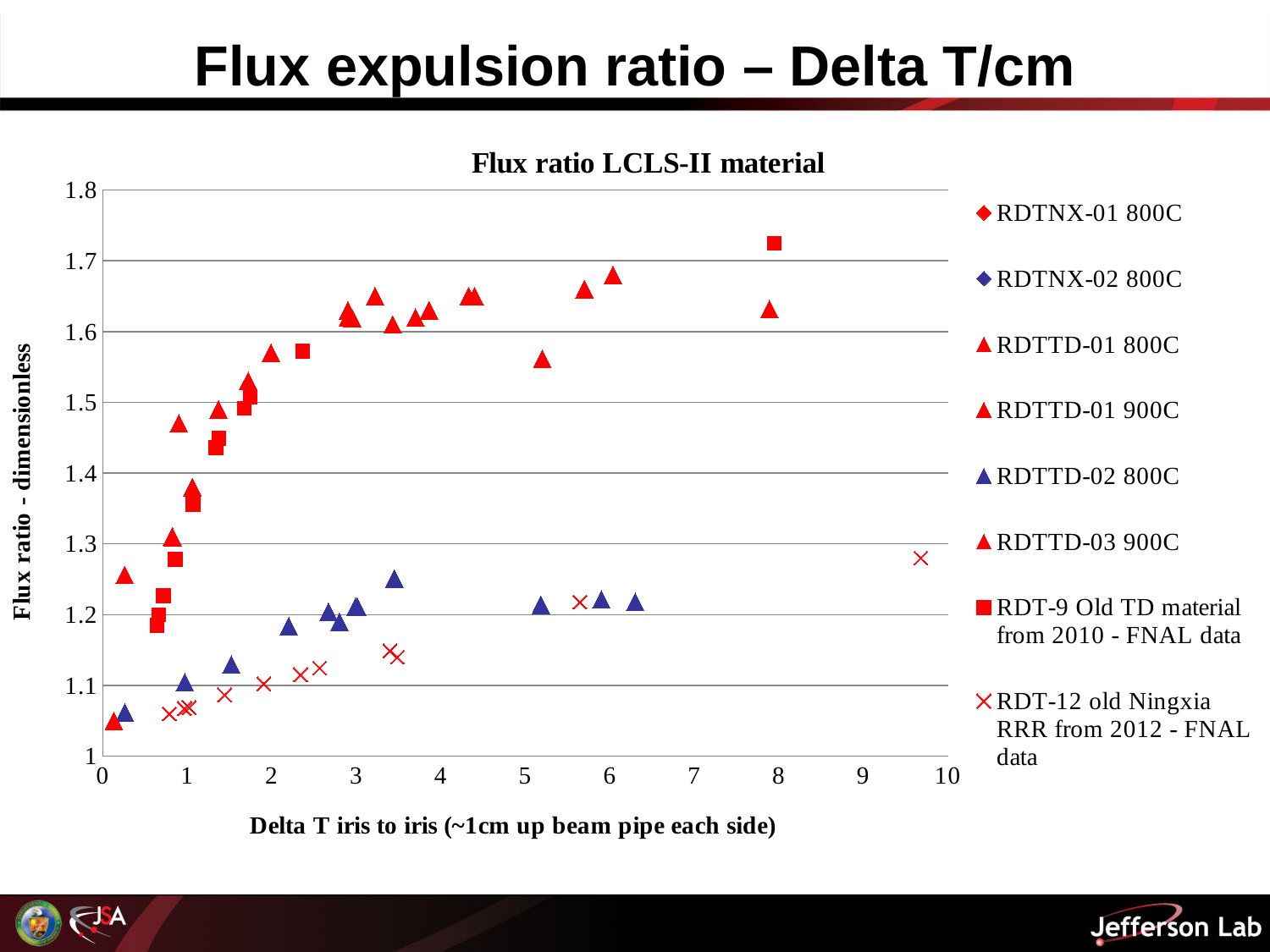
How many series does the legend list? 8 Are the RDTTD-02 800C points greater or less than 1.3 on the flux ratio axis? less What kind of chart is shown on the slide? Scatter chart Near Delta T of 6, which is larger: the red triangle flux ratio or the blue triangle flux ratio? red triangle What is the label of the vertical axis? Flux ratio - dimensionless Which series contains the highest plotted point on the chart? RDT-9 Old TD material from 2010 - FNAL data What is the title of the chart? Flux ratio LCLS-II material What is the maximum value shown on the flux ratio axis? 1.8 Is the RDT-9 Old TD material point plotted near Delta T of 8 greater or less than 1.7 on the flux ratio axis? greater Is the RDT-12 old Ningxia point plotted near Delta T of 9.7 greater or less than 1.2 on the flux ratio axis? greater Do the red triangle flux ratio values generally rise or fall as Delta T increases? rise